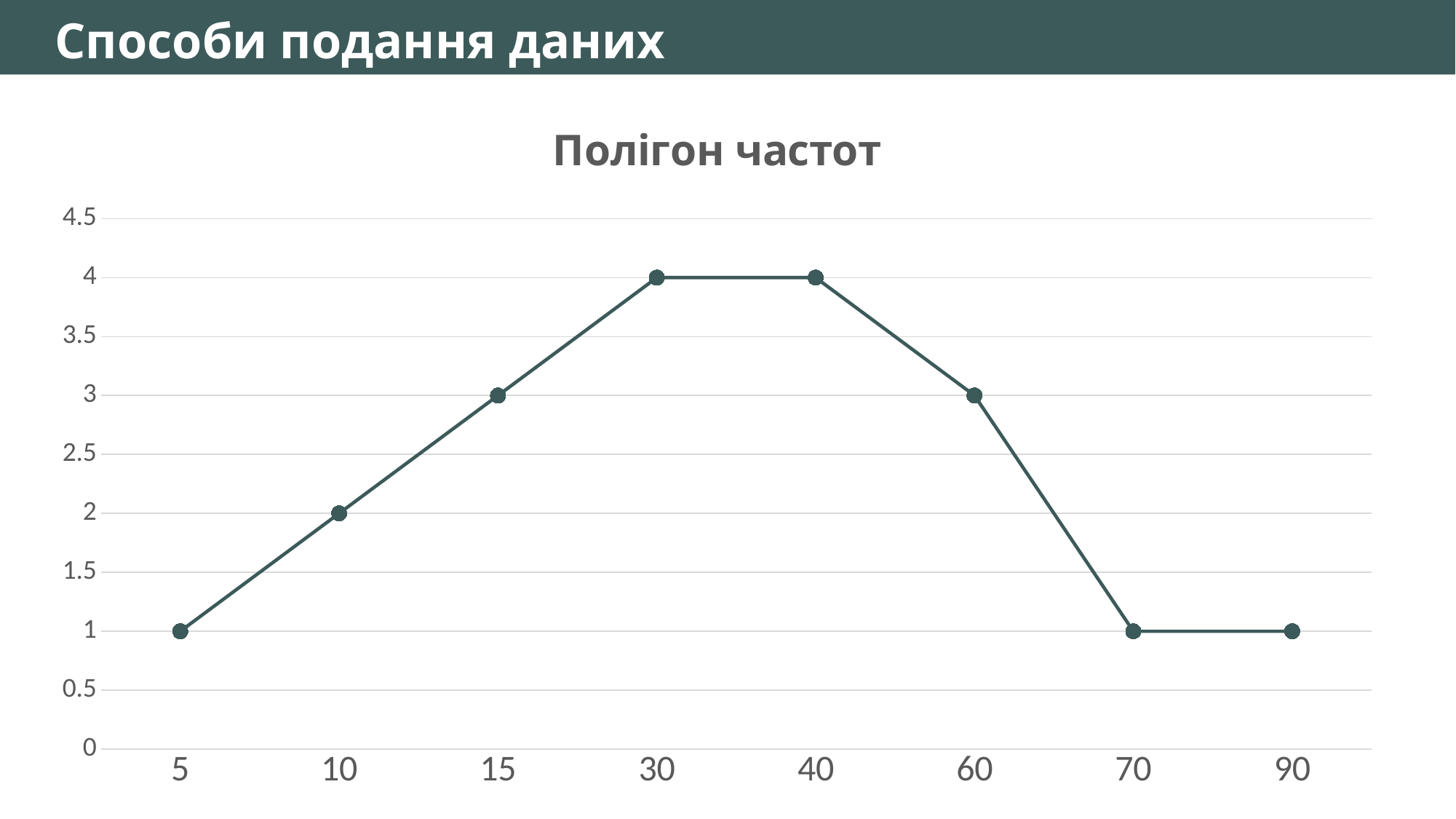
What is the value at x = 10? 2 What is the value at x = 15? 3 What is the highest value reached on the chart? 4 Is the value at x = 40 greater or less than 3.5? greater Do the values rise or fall between x = 5 and x = 30? rise What is the value at x = 5? 1 What is the title of the chart? Полігон частот How many data points are plotted on the chart? 8 What is the difference between the value at x = 30 and the value at x = 70? 3 Which is larger, the value at x = 15 or the value at x = 70? 15 What is the value at x = 60? 3 What type of chart is shown on the slide? line chart